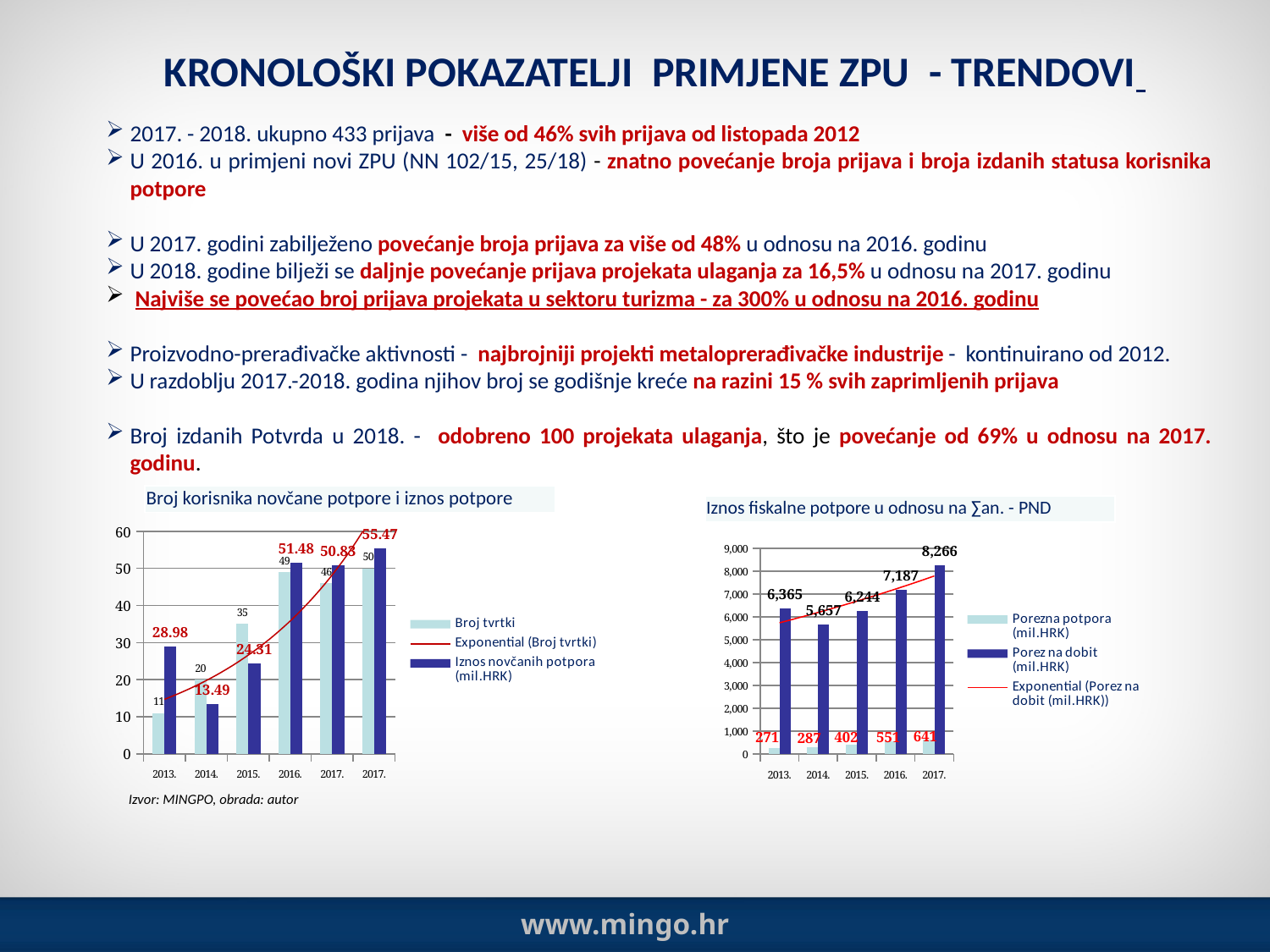
In the chart 'Iznos fiskalne potpore u odnosu na ∑an. - PND', which year has the highest Porez na dobit (mil.HRK)? 2017. In the chart 'Broj korisnika novčane potpore i iznos potpore', what is the value of Broj tvrtki for 2015.? 35 In the chart 'Iznos fiskalne potpore u odnosu na ∑an. - PND', which year has the lowest Porez na dobit (mil.HRK)? 2014. In the chart 'Iznos fiskalne potpore u odnosu na ∑an. - PND', does Porezna potpora (mil.HRK) rise or fall from 2013. to 2017.? rise In the chart 'Iznos fiskalne potpore u odnosu na ∑an. - PND', what is the value of Porez na dobit (mil.HRK) for 2016.? 7,187 In the chart 'Broj korisnika novčane potpore i iznos potpore', what is the value of Iznos novčanih potpora (mil.HRK) for 2014.? 13.49 In the chart 'Iznos fiskalne potpore u odnosu na ∑an. - PND', how many series does the legend list? 3 In the chart 'Iznos fiskalne potpore u odnosu na ∑an. - PND', is the Porez na dobit (mil.HRK) value for 2014. greater or less than 6,000? less In the chart 'Iznos fiskalne potpore u odnosu na ∑an. - PND', what is the difference between Porez na dobit (mil.HRK) in 2017. and in 2013.? 1,901 In the chart 'Iznos fiskalne potpore u odnosu na ∑an. - PND', what is the value of Porezna potpora (mil.HRK) for 2015.? 402 In the chart 'Broj korisnika novčane potpore i iznos potpore', which year has the lowest Iznos novčanih potpora (mil.HRK)? 2014. In the chart 'Broj korisnika novčane potpore i iznos potpore', how many categories are shown on the x axis? 6